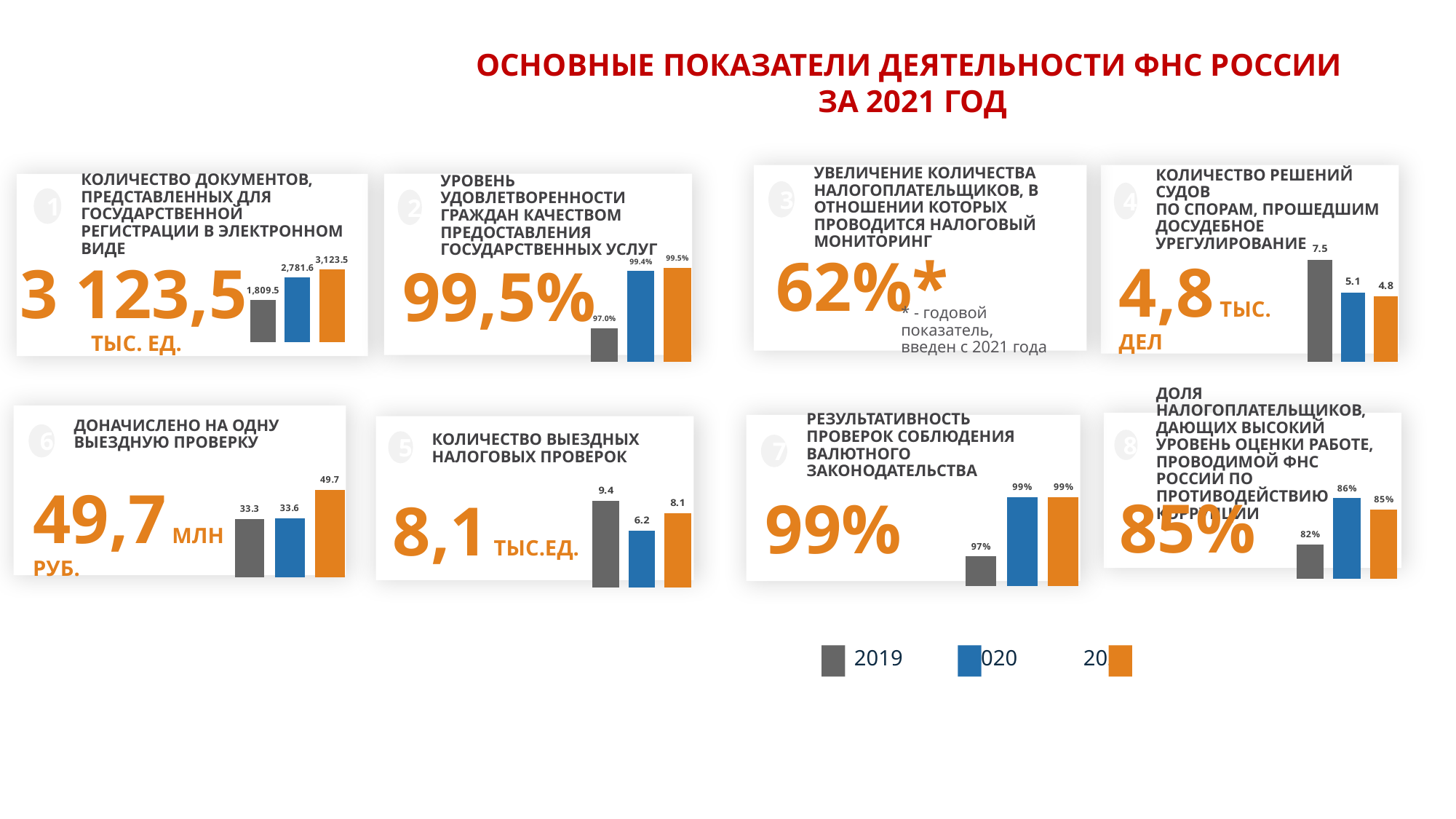
In the chart for "Количество выездных налоговых проверок", which year has the lowest value? 2020 In the chart for "Количество документов, представленных для государственной регистрации в электронном виде", what is the difference between the 2021 and 2019 values? 1,314.0 In the chart for "Количество выездных налоговых проверок", what is the value for 2020? 6.2 In the chart for "Доначислено на одну выездную проверку", what is the difference between the 2021 and 2020 values? 16.1 In the chart for "Доля налогоплательщиков, дающих высокий уровень оценки работе, проводимой ФНС России по противодействию коррупции", which is larger, the 2020 value or the 2019 value? 2020 What type of chart is used in the "Доначислено на одну выездную проверку" panel? bar chart In the chart for "Количество документов, представленных для государственной регистрации в электронном виде", what is the value for 2020? 2,781.6 In the chart for "Результативность проверок соблюдения валютного законодательства", what is the value for 2019? 97% How many series does the legend at the bottom of the slide list? 3 In the chart for "Уровень удовлетворенности граждан качеством предоставления государственных услуг", what is the value for 2019? 97.0% In the chart for "Количество решений судов по спорам, прошедшим досудебное урегулирование", do the values rise or fall from 2019 to 2021? fall In the chart for "Количество решений судов по спорам, прошедшим досудебное урегулирование", which year has the highest value? 2019